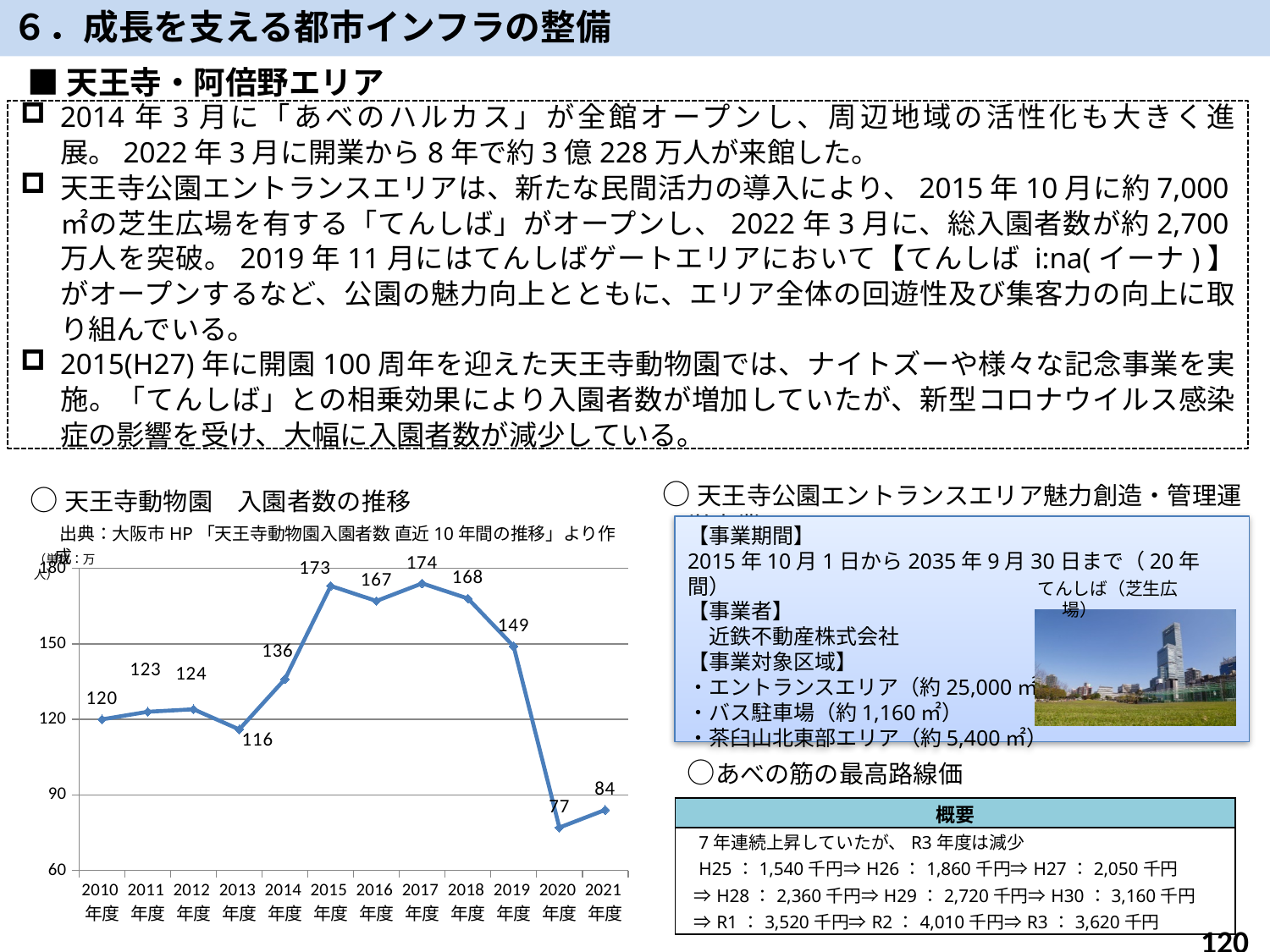
How many years are plotted in the 天王寺動物園 入園者数の推移 chart? 12 In the 天王寺動物園 入園者数の推移 chart, which is larger, the value for 2016年度 or 2018年度? 2018年度 In the 天王寺動物園 入園者数の推移 chart, what is the value for 2015年度? 173 In the 天王寺動物園 入園者数の推移 chart, which year has the lowest value? 2020年度 In the 天王寺動物園 入園者数の推移 chart, what is the difference between the values for 2014年度 and 2015年度? 37 In the 天王寺動物園 入園者数の推移 chart, which year has the highest value? 2017年度 In the 天王寺動物園 入園者数の推移 chart, do the values rise or fall from 2019年度 to 2020年度? fall In the 天王寺動物園 入園者数の推移 chart, what is the difference between the values for 2019年度 and 2020年度? 72 In the 天王寺動物園 入園者数の推移 chart, what is the value for 2010年度? 120 What is the source cited below the title of the 天王寺動物園 入園者数の推移 chart? 大阪市HP「天王寺動物園入園者数 直近10年間の推移」 What type of chart is used to show the 天王寺動物園 入園者数の推移? line chart In the 天王寺動物園 入園者数の推移 chart, what is the value for 2020年度? 77